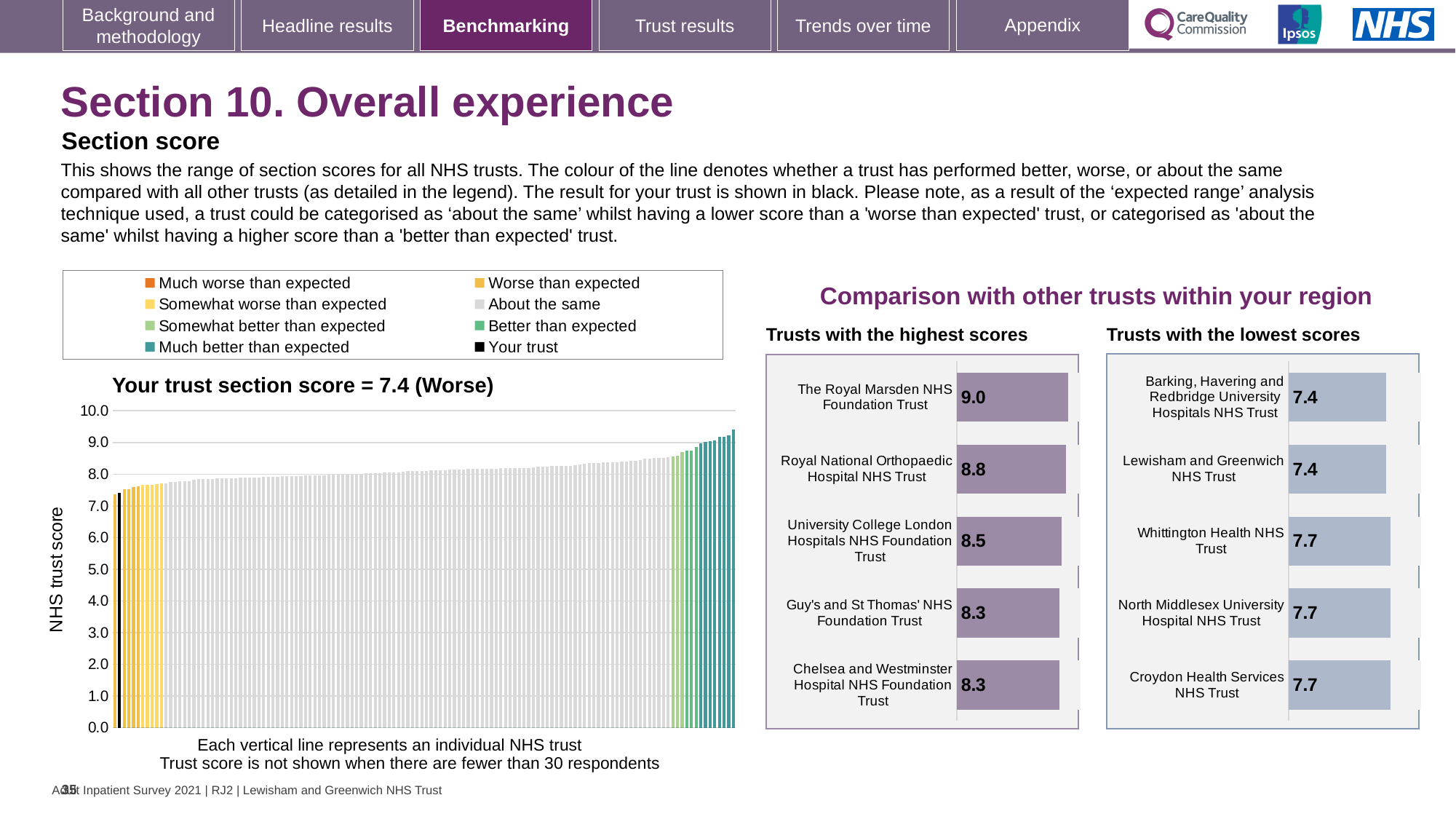
In the 'Your trust section score' chart, what is the section score for your trust? 7.4 In the 'Your trust section score' chart, how many entries does the legend list? 8 What kind of chart is the 'Your trust section score' chart? Bar chart In the 'Trusts with the lowest scores' chart, which has the larger score: Whittington Health NHS Trust or Lewisham and Greenwich NHS Trust? Whittington Health NHS Trust In the 'Your trust section score' chart, what colour is the bar for your trust? Black In the 'Your trust section score' chart, is the value of the rightmost bar greater or less than 9.0? greater In the 'Trusts with the highest scores' chart, which trust has the highest score? The Royal Marsden NHS Foundation Trust In the 'Trusts with the lowest scores' chart, what is the score for Croydon Health Services NHS Trust? 7.7 How many trusts are shown in the 'Trusts with the lowest scores' chart? 5 In the 'Your trust section score' chart, do the trust scores rise or fall from left to right? Rise In the 'Trusts with the highest scores' chart, what is the difference between the scores of The Royal Marsden NHS Foundation Trust and Royal National Orthopaedic Hospital NHS Trust? 0.2 In the 'Trusts with the highest scores' chart, what is the score for The Royal Marsden NHS Foundation Trust? 9.0